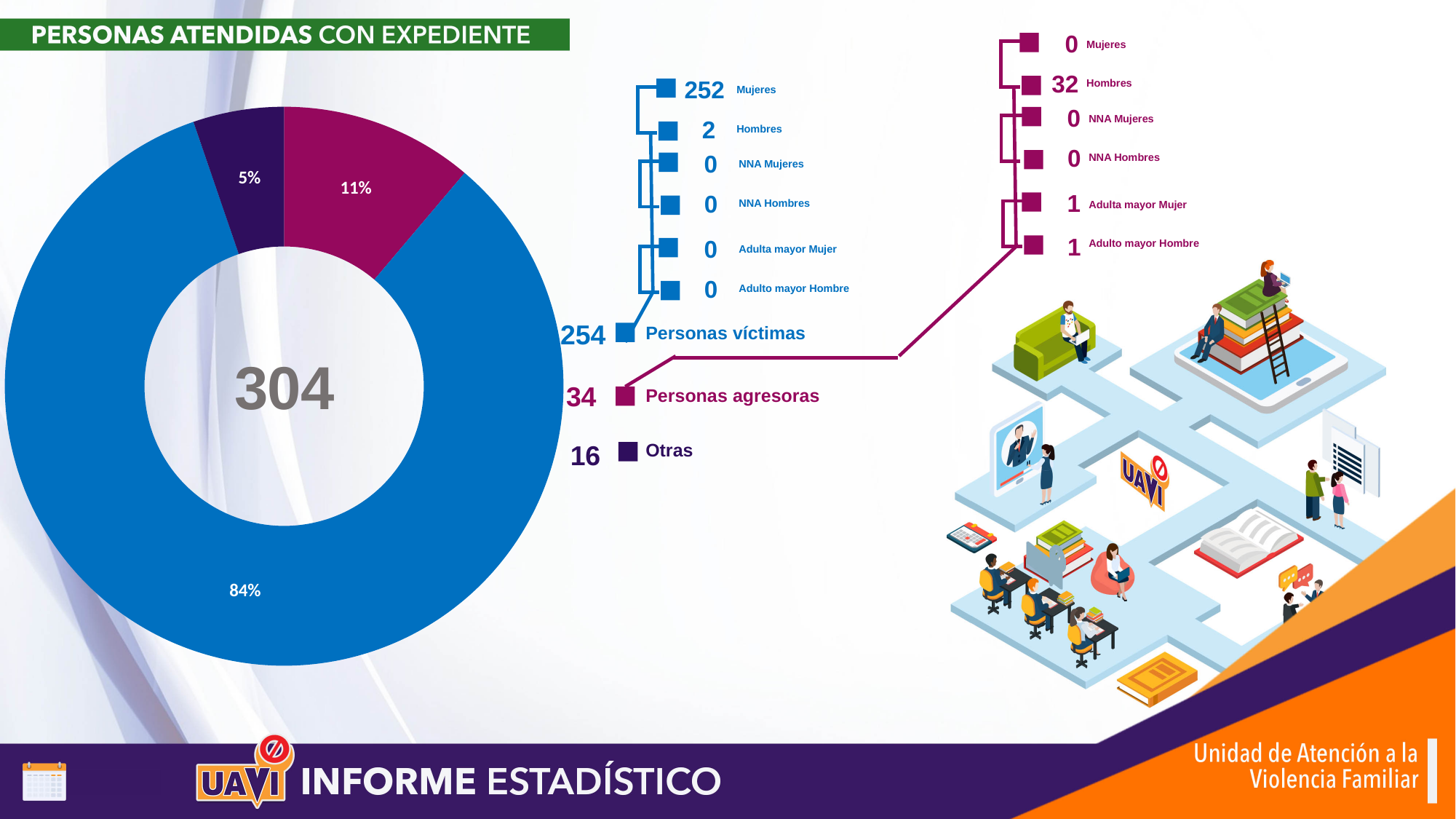
What percentage of the donut chart corresponds to Otras? 5% What percentage of the donut chart corresponds to Personas víctimas? 84% What is the difference in percentage points between the Personas víctimas slice and the Personas agresoras slice? 73 percentage points What kind of chart is shown on the slide? Donut (pie) chart What colour is the Personas agresoras slice in the donut chart? Magenta (purple-red) How many Personas agresoras are listed in the legend? 34 What percentage of the donut chart corresponds to Personas agresoras? 11% Which category has the largest slice in the donut chart? Personas víctimas How many slices does the donut chart have? 3 How many Personas víctimas are listed in the legend? 254 Which category has the smallest slice in the donut chart? Otras What total number is shown in the center of the donut chart? 304